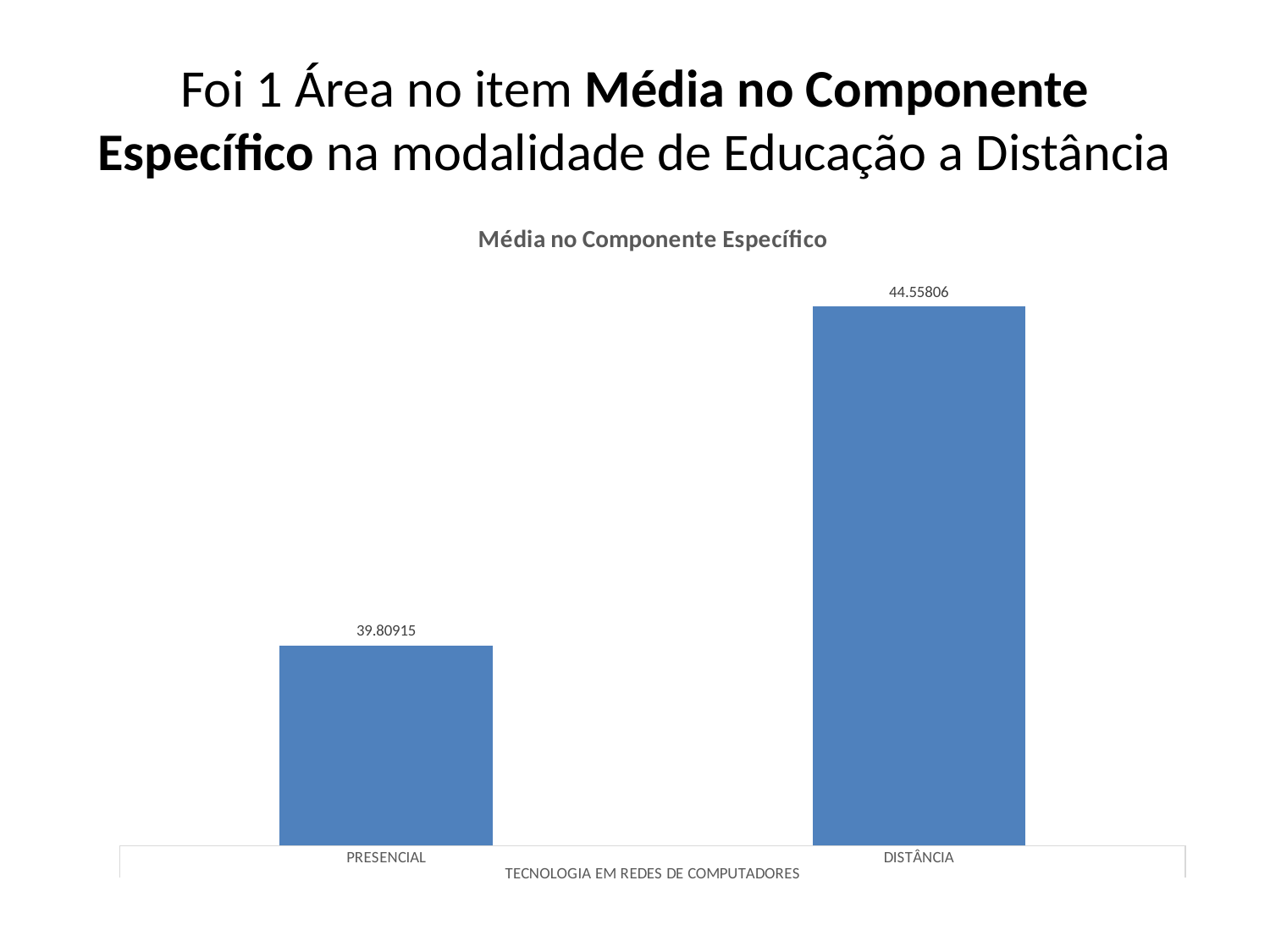
What is the value for DISTÂNCIA? 44.55806 Which is larger, the value for PRESENCIAL or the value for DISTÂNCIA? DISTÂNCIA Do the values rise or fall from PRESENCIAL to DISTÂNCIA? Rise Which category has the lowest value? PRESENCIAL What is the value for PRESENCIAL? 39.80915 What is the title of the chart? Média no Componente Específico Which category has the highest value? DISTÂNCIA What is the label shown below the category axis of the chart? TECNOLOGIA EM REDES DE COMPUTADORES What kind of chart is shown on the slide? Bar chart What is the difference between the values for DISTÂNCIA and PRESENCIAL? 4.74891 How many categories are shown in the chart? 2